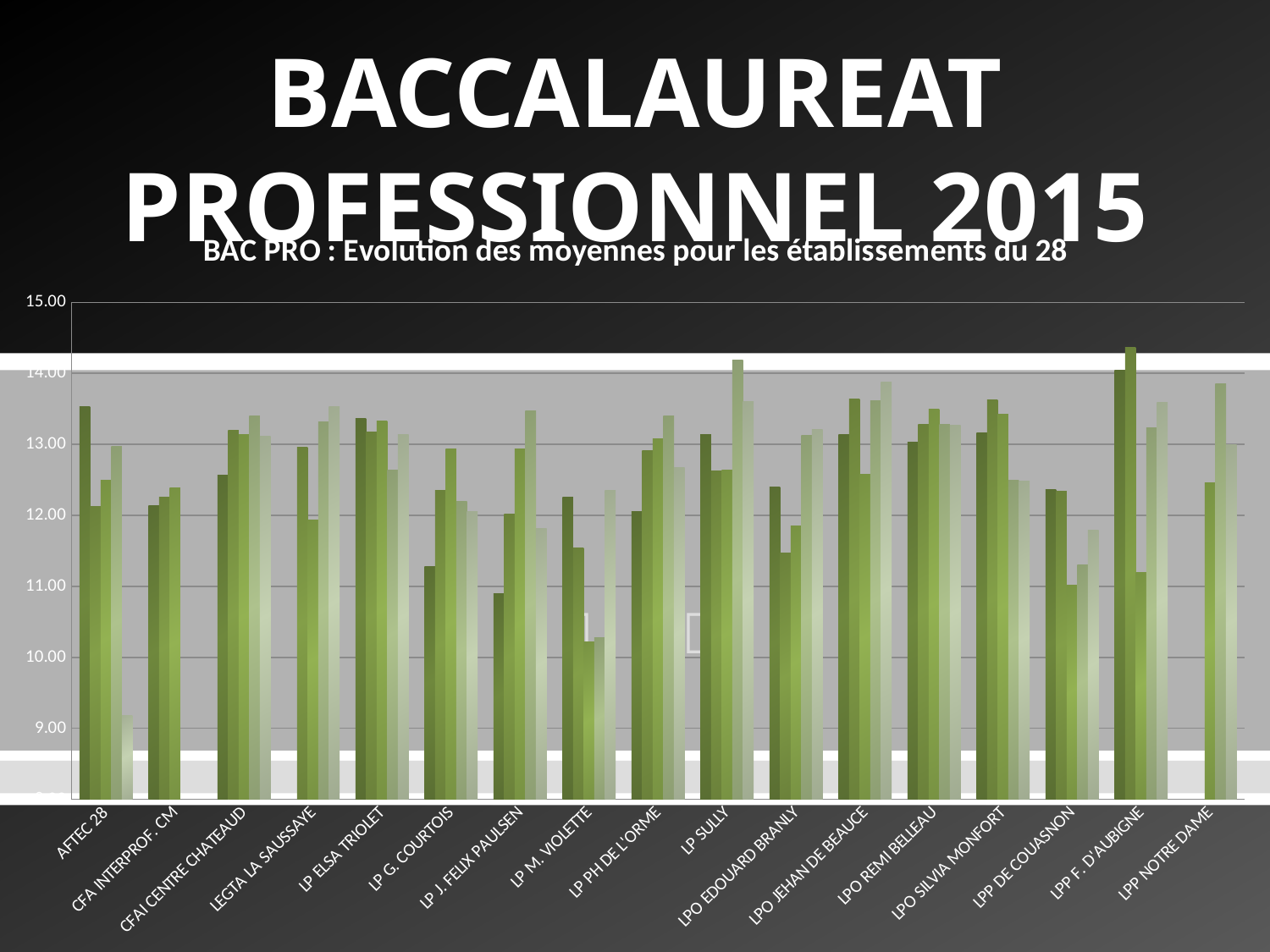
Which establishment has the shortest bar in the whole chart? AFTEC 28 Is the tallest bar for LPP F. D'AUBIGNE greater or less than 14.00? greater What is the highest value shown on the vertical axis of the chart? 15.00 How many establishments (categories) are shown on the x axis of the chart? 17 Is the tallest bar for LP M. VIOLETTE greater or less than 13.00? less Is the shortest bar for LP M. VIOLETTE greater or less than 11.00? less What is the title of the chart? BAC PRO : Evolution des moyennes pour les établissements du 28 Which is taller: the tallest bar for LP SULLY or the tallest bar for LP M. VIOLETTE? LP SULLY What kind of chart is shown on the slide? Bar chart